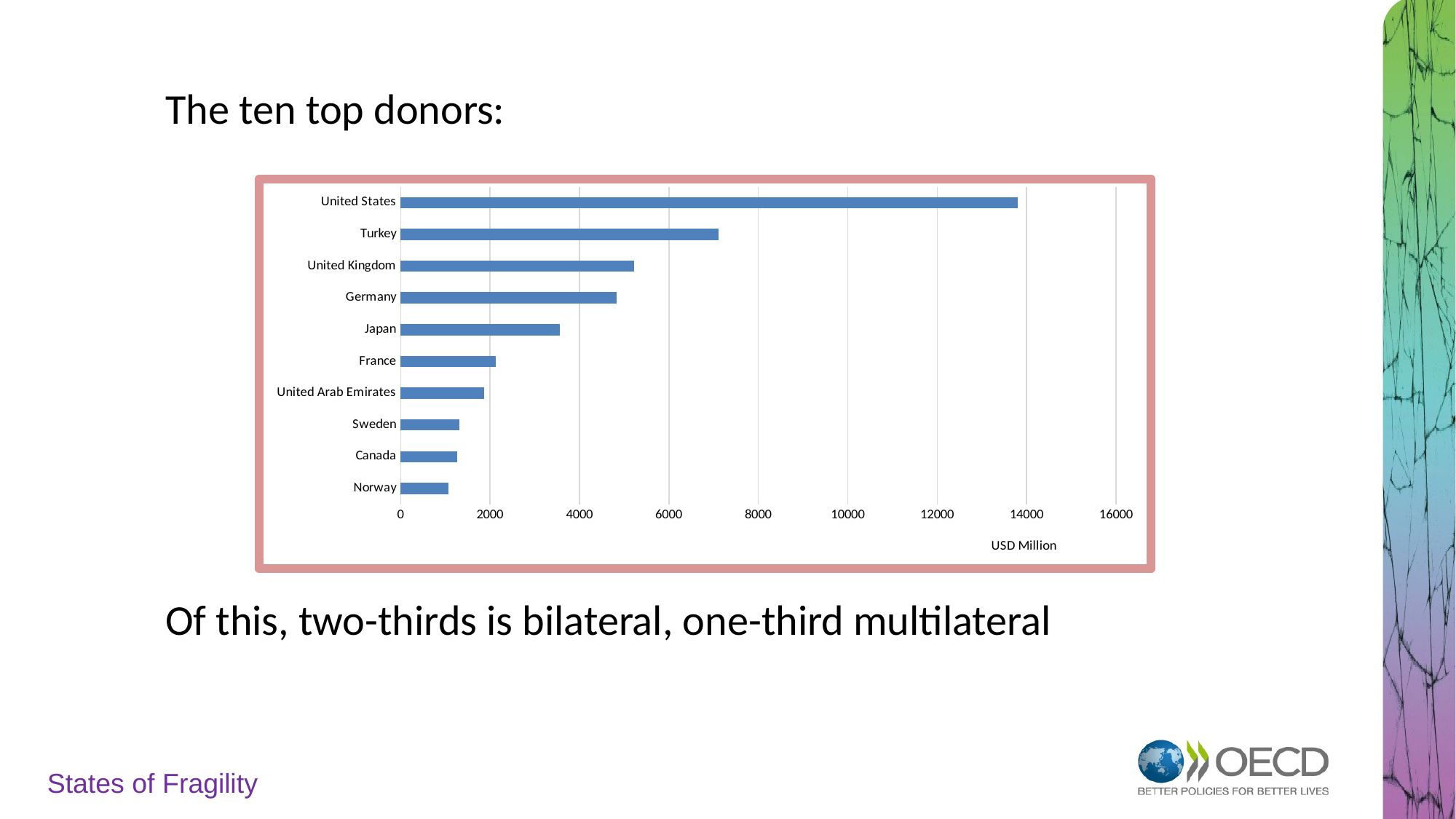
Which is larger, the value for the United Kingdom or the value for Japan? United Kingdom How many donors are shown in the chart? 10 Is the value for the United States greater or less than 12000? greater Is the value for Germany greater or less than 6000? less Which donor has the lowest value in the chart? Norway Which is larger, the value for Turkey or the value for Germany? Turkey Is the value for Turkey greater or less than 6000? greater Which donor has the highest value in the chart? United States What kind of chart is shown on the slide? bar chart What unit is shown on the horizontal axis of the chart? USD Million